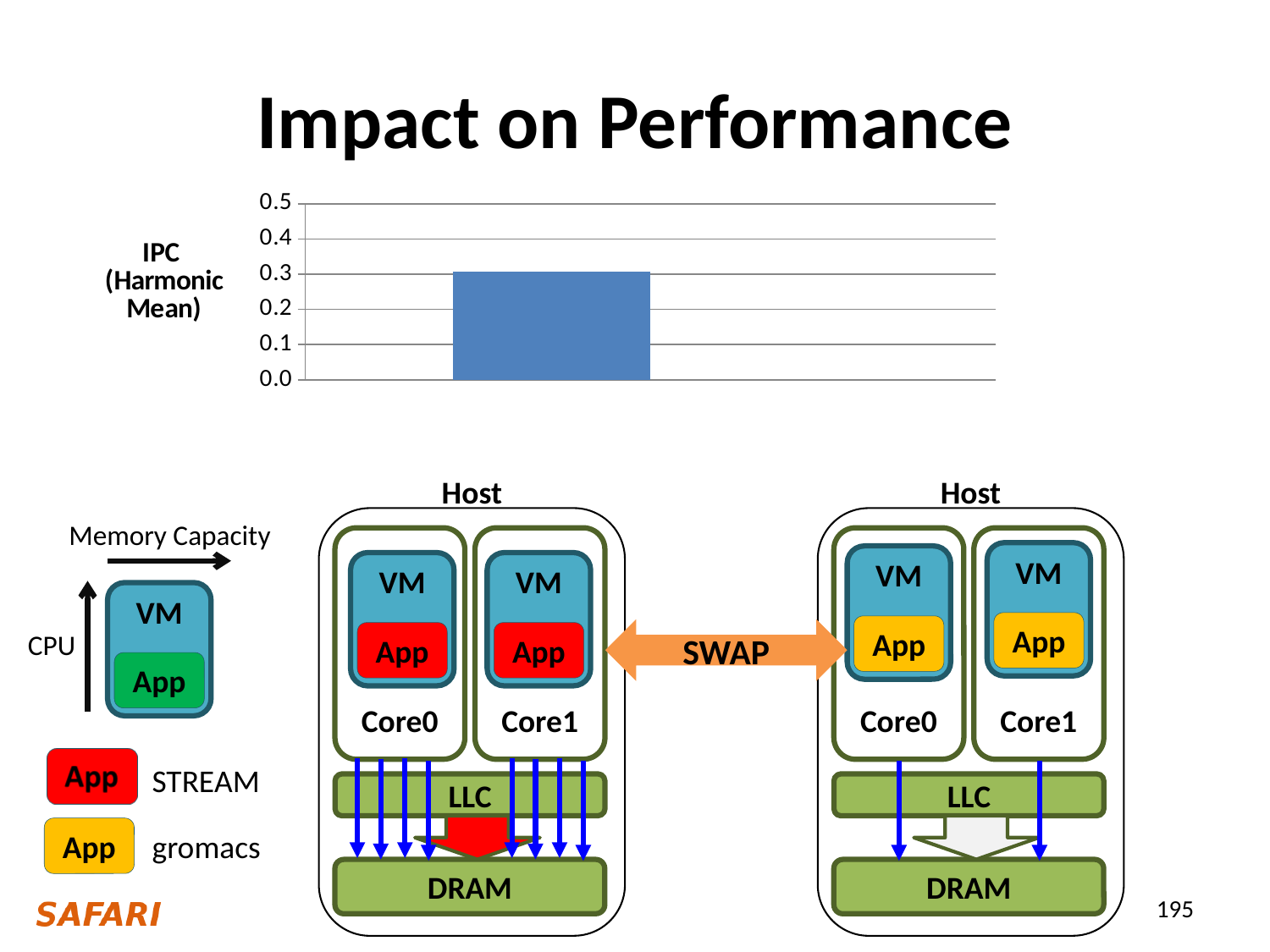
Is the value of the bar in the chart greater or less than 0.1? greater What is the label of the vertical axis of the chart? IPC (Harmonic Mean) What is the highest tick value shown on the vertical axis of the chart? 0.5 How many bars are plotted in the chart? 1 Is the value of the bar in the chart greater or less than 0.4? less What kind of chart is shown on the slide? bar chart Is the value of the bar in the chart greater or less than 0.2? greater